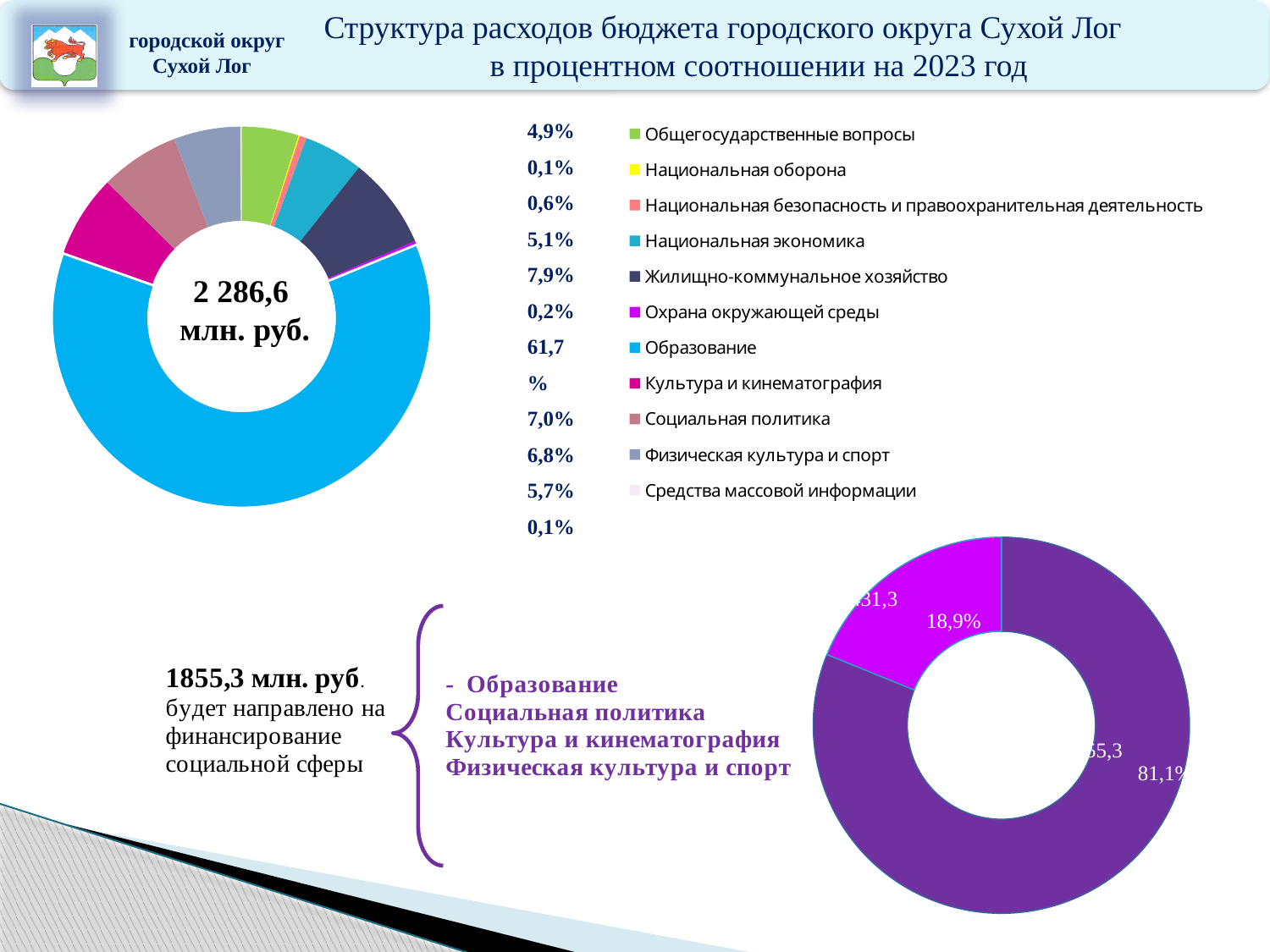
How many slices does the bottom-right doughnut chart have? 2 What total amount is printed in the centre of the top-left doughnut chart? 2 286,6 млн. руб. In the top-left doughnut chart, what share is shown for Национальная экономика? 5,1% In the top-left doughnut chart, which category has the largest share? Образование In the bottom-right doughnut chart, what is the share of the smaller slice? 18,9% What kind of chart is the top-left chart? Doughnut (pie) chart In the top-left doughnut chart, what share of budget expenditure goes to Образование? 61,7% How many categories does the legend of the top-left doughnut chart list? 11 In the top-left doughnut chart, which category has a larger share: Культура и кинематография or Социальная политика? Культура и кинематография In the bottom-right doughnut chart, what is the share of the largest slice? 81,1% In the top-left doughnut chart, what share is shown for Жилищно-коммунальное хозяйство? 7,9% In the top-left doughnut chart, what is the difference between the shares of Образование and Жилищно-коммунальное хозяйство? 53,8%